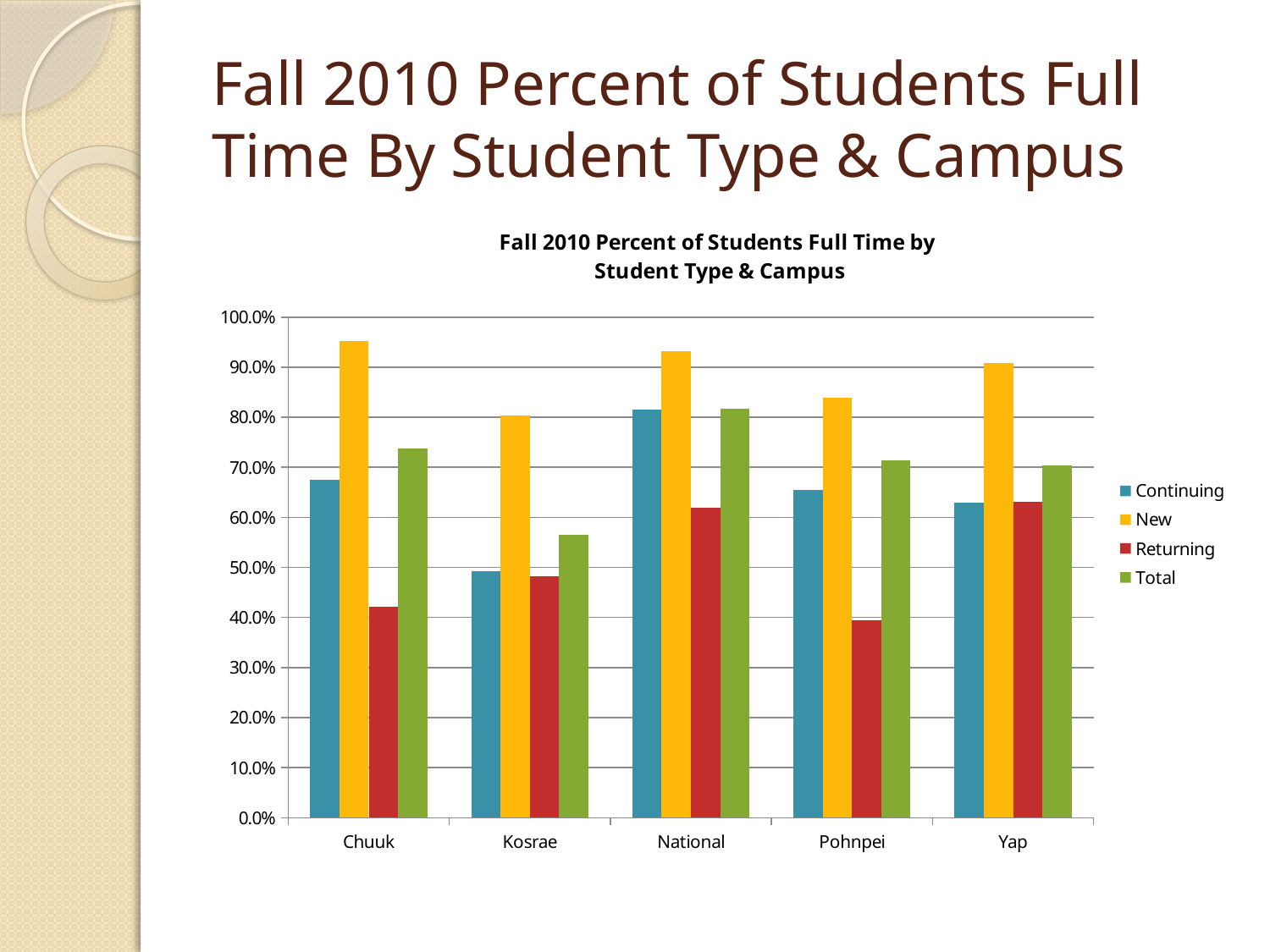
Is the Returning value for Pohnpei greater or less than 50.0%? less What kind of chart is shown on the slide? Bar chart Is the Returning value for Kosrae greater or less than 50.0%? less How many campuses are shown on the x axis? 5 Which campus has the lowest Continuing value? Kosrae Is the New value for Chuuk greater or less than 90.0%? greater What colour represents the New series in the legend? Yellow Which campus has the lowest Total value? Kosrae Which is larger: the Returning value for National or the Returning value for Pohnpei? National For Chuuk, which is larger: the Continuing value or the Returning value? Continuing How many series does the legend list? 4 Which campus has the highest Continuing value? National